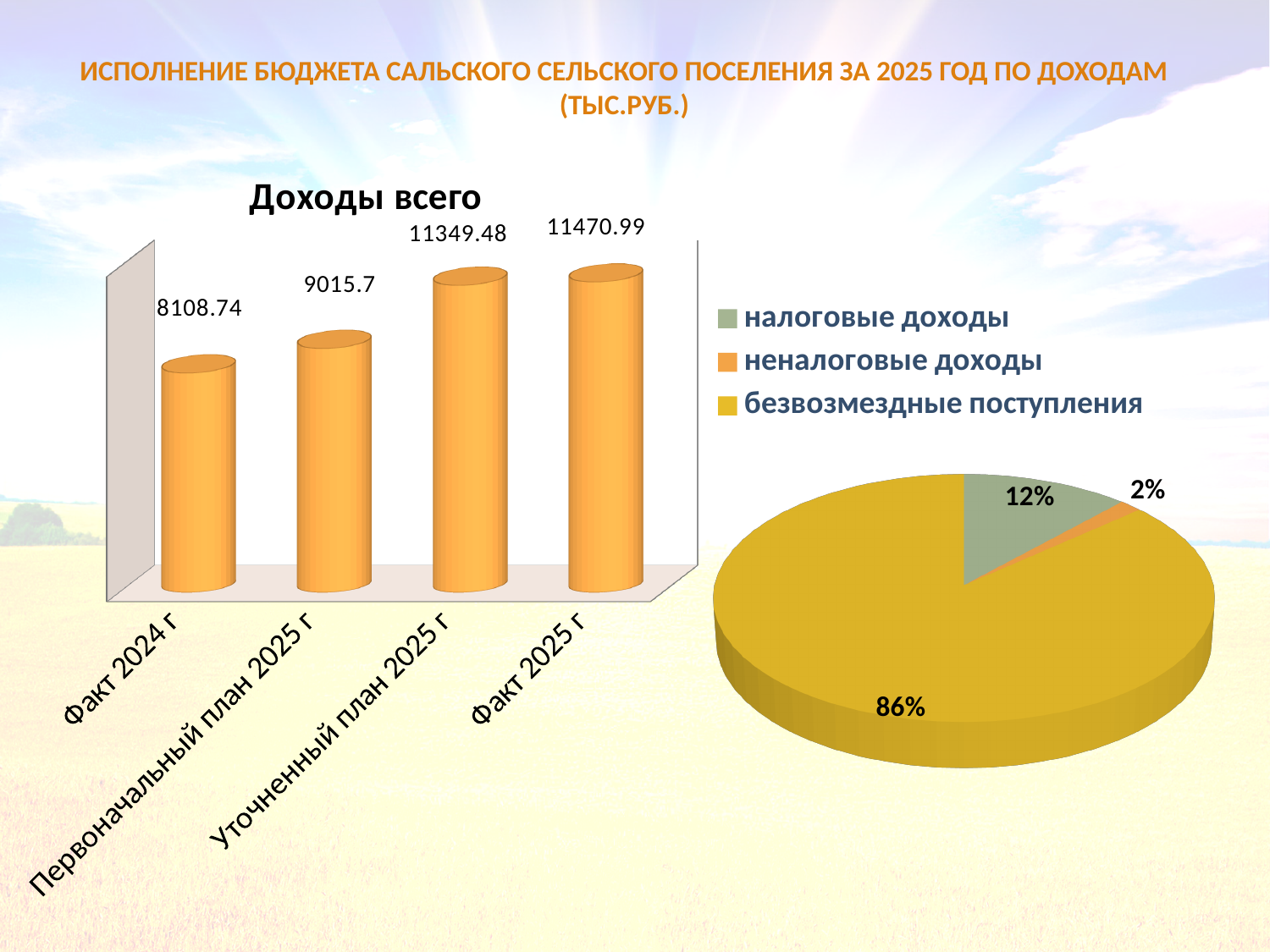
In the bar chart "Доходы всего", do the values rise or fall from left to right along the x axis? rise In the bar chart "Доходы всего", what is the value for Уточненный план 2025 г? 11349.48 In the bar chart "Доходы всего", which category has the highest value? Факт 2025 г In the bar chart "Доходы всего", which category has the lowest value? Факт 2024 г In the bar chart "Доходы всего", what is the value for Факт 2024 г? 8108.74 How many series does the legend of the pie chart on the right list? 3 In the pie chart on the right, what share is безвозмездные поступления? 86% In the bar chart "Доходы всего", what is the value for Первоначальный план 2025 г? 9015.7 In the bar chart "Доходы всего", what is the difference between Факт 2025 г and Факт 2024 г? 3362.25 In the bar chart "Доходы всего", how many categories are shown? 4 In the pie chart on the right, what share is налоговые доходы? 12% In the bar chart "Доходы всего", which is larger: Первоначальный план 2025 г or Уточненный план 2025 г? Уточненный план 2025 г